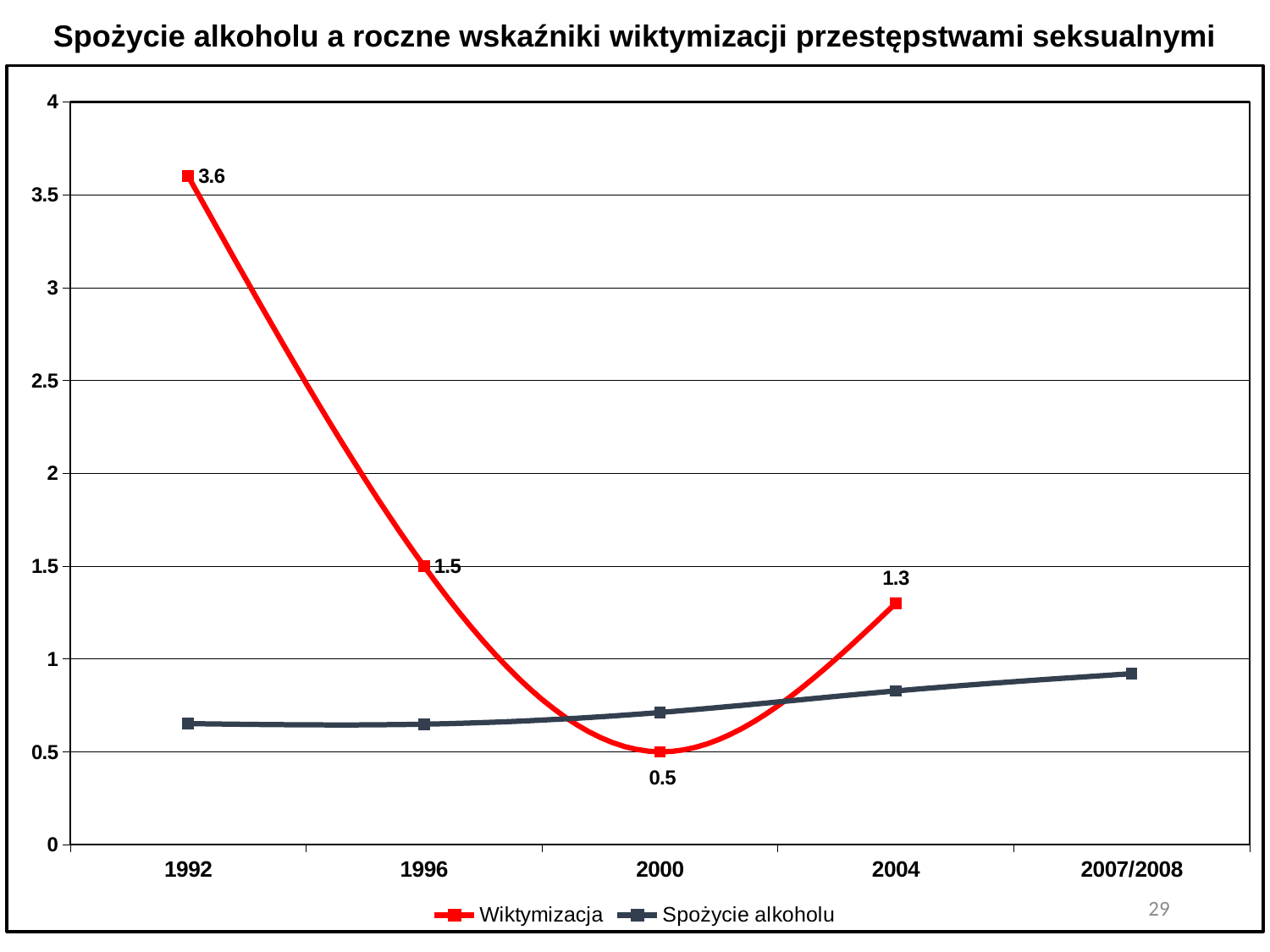
Which is larger, the Wiktymizacja value for 1996 or for 2004? 1996 Does the Spożycie alkoholu series rise or fall from 1996 to 2007/2008? rise What is the difference between the Wiktymizacja values for 1992 and 1996? 2.1 Is the Spożycie alkoholu value for 1992 greater or less than 0.5? greater What kind of chart is shown on the slide? line chart What is the Wiktymizacja value for 2004? 1.3 What is the Wiktymizacja value for 1992? 3.6 What is the Wiktymizacja value for 2000? 0.5 Is the Spożycie alkoholu value for 2007/2008 greater or less than 1? less How many series does the legend list? 2 In which year is the Wiktymizacja series lowest? 2000 In which year is the Wiktymizacja series highest? 1992